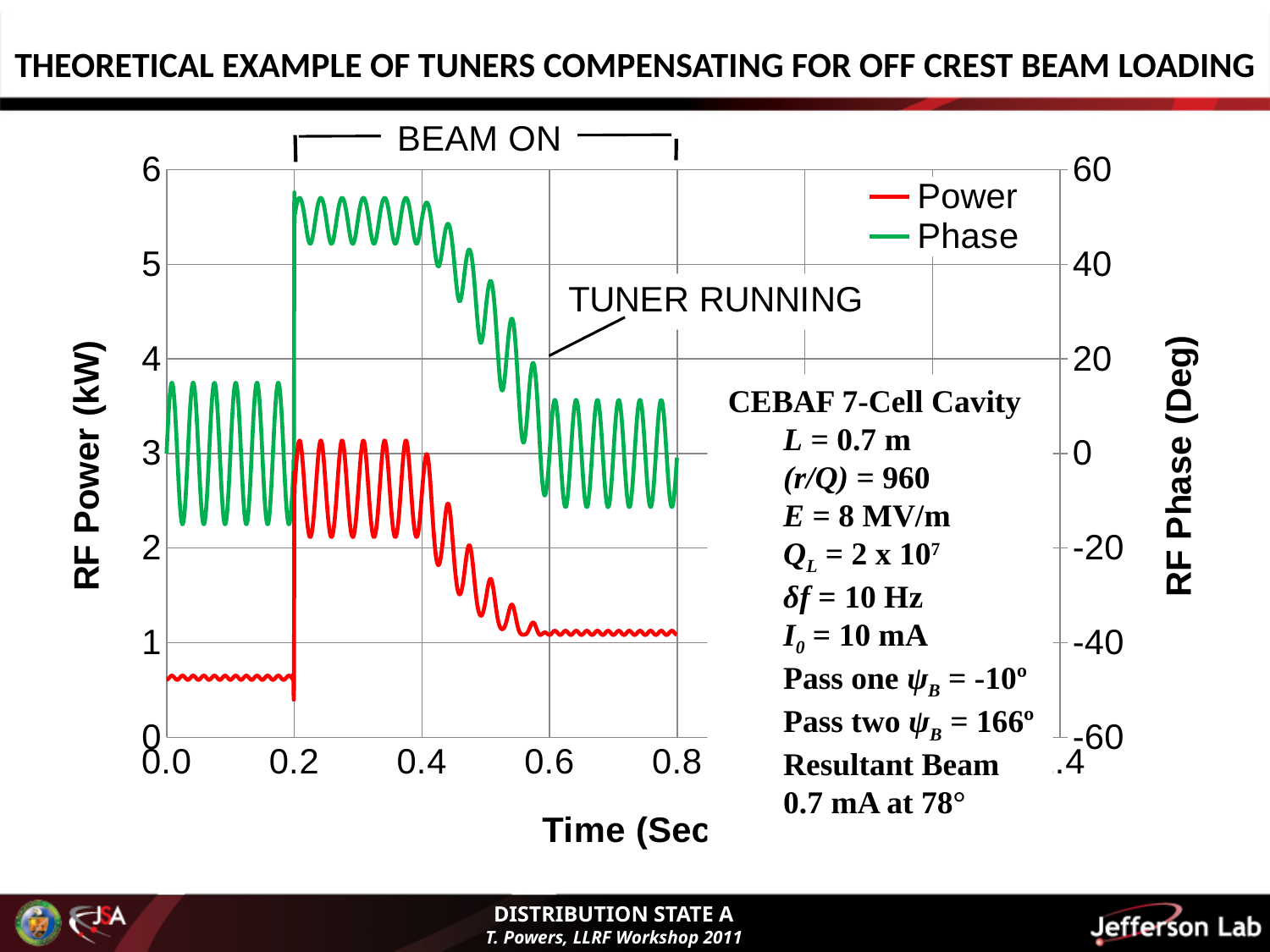
What kind of chart is shown on the slide? line chart Is the Power value just before 0.2 seconds greater or less than 1 kW? less What is the label of the left vertical axis? RF Power (kW) Which series has the higher value on its own axis between 0.2 and 0.4 seconds, Power (in kW) or Phase (in degrees)? Phase Does the Phase series rise or fall between 0.4 and 0.6 seconds? fall Which series is drawn in red on the chart? Power Is the peak Power value between 0.2 and 0.4 seconds greater or less than 2 kW? greater Does the Power series rise or fall at 0.2 seconds when the beam turns on? rise Is the Phase value between 0.2 and 0.4 seconds greater or less than 40 degrees? greater How many series does the chart legend list? 2 Does the Power series rise or fall between 0.4 and 0.6 seconds? fall